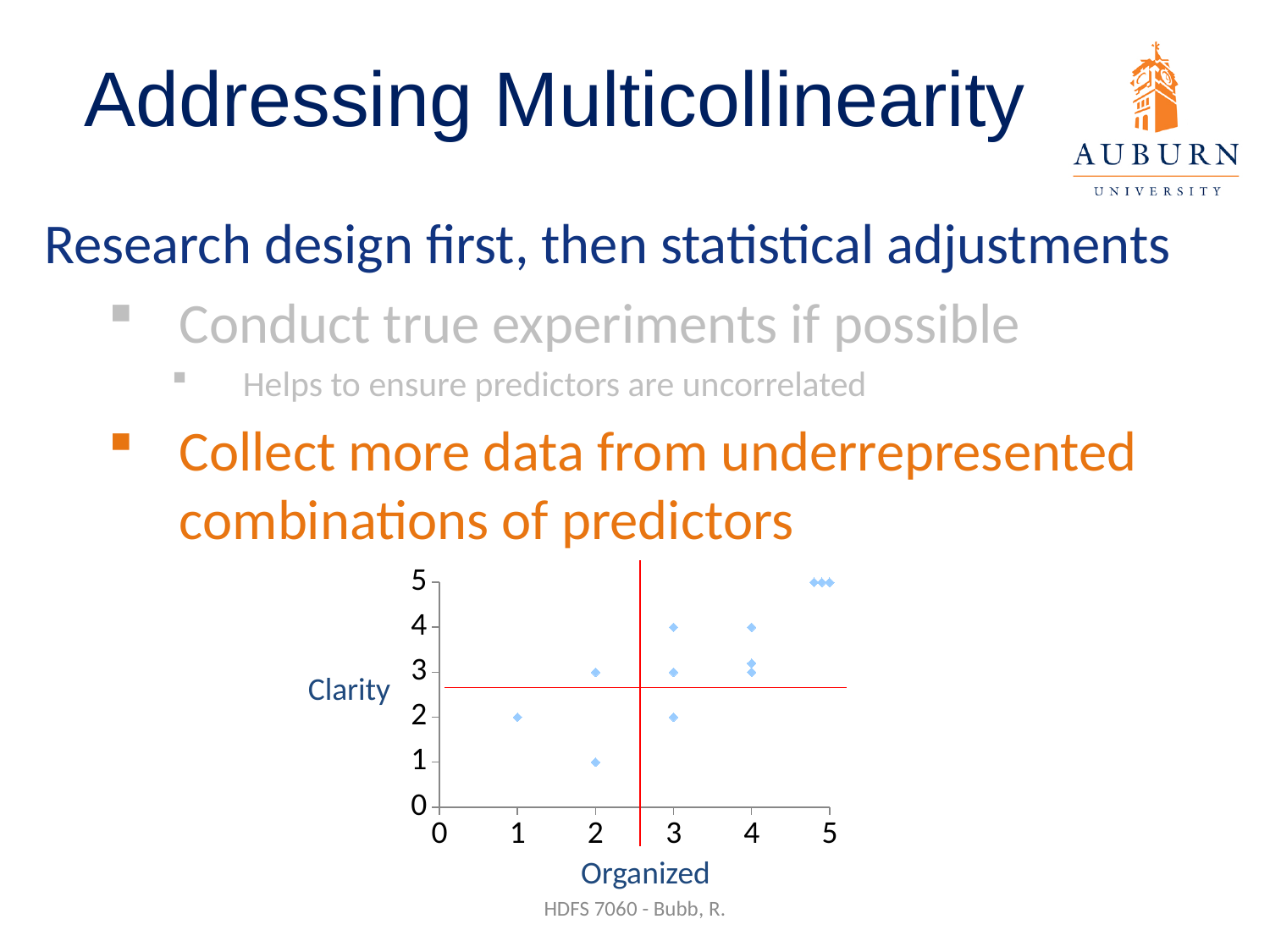
Is the Clarity value of the point at Organized = 1 greater or less than 3? less What is the maximum value shown on the Organized axis? 5 How many points are plotted at Organized = 3? 3 What is the label of the vertical axis of the chart? Clarity Which has the higher Clarity value: the point at Organized = 1 or the highest point at Organized = 3? the highest point at Organized = 3 What is the highest Clarity value plotted on the chart? 5 Do the Clarity values generally rise or fall as Organized increases? rise What is the difference between the highest and lowest Clarity values plotted at Organized = 2? 2 What is the lowest Clarity value plotted on the chart? 1 What kind of chart is shown on the slide? scatter chart What is the label of the horizontal axis of the chart? Organized What is the Clarity value of the point plotted at Organized = 1? 2